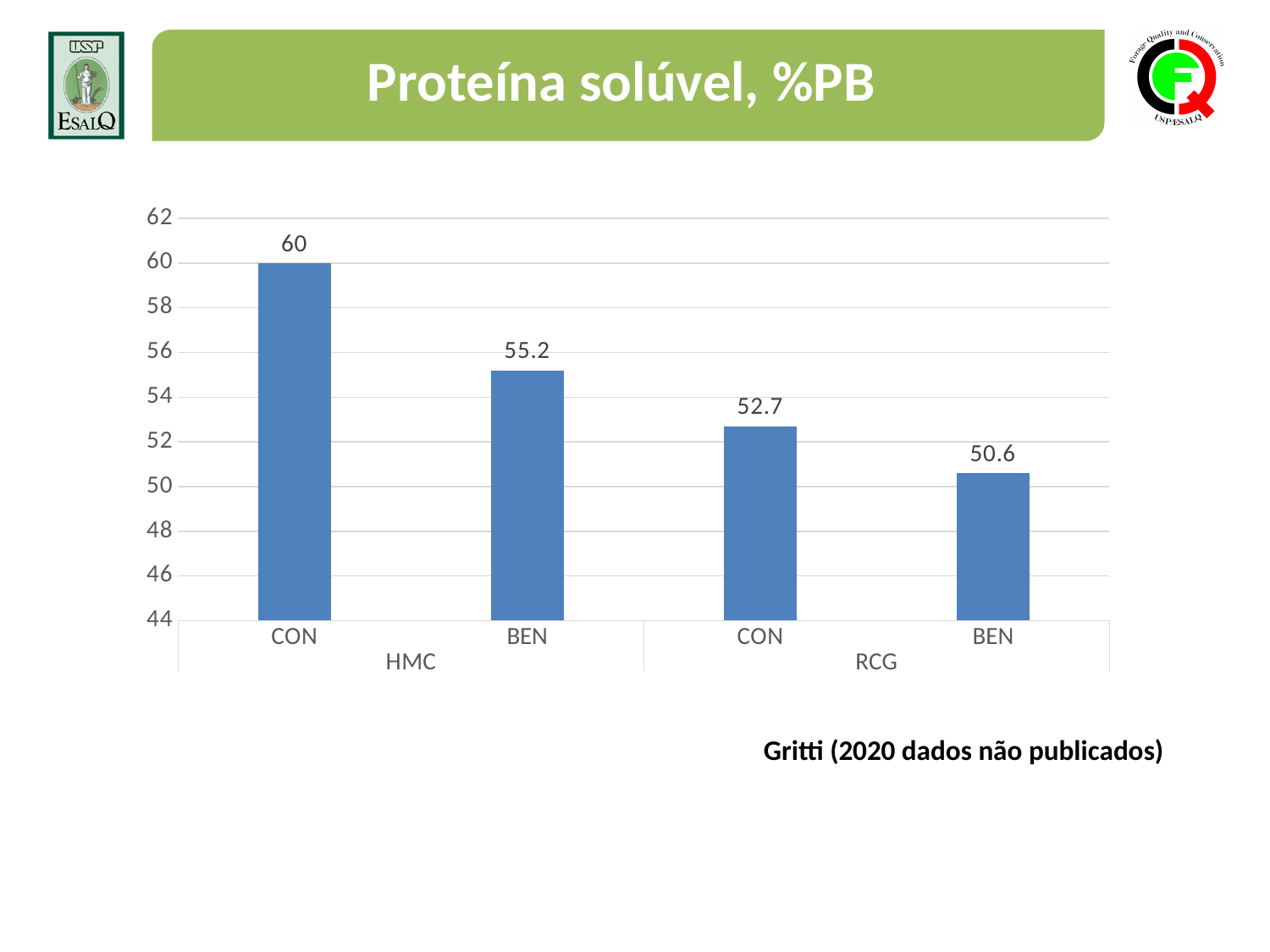
Which is larger, BEN under HMC or CON under RCG? BEN under HMC Which bar has the lowest value? BEN under RCG What is the title of the chart? Proteína solúvel, %PB How many bars are plotted in the chart? 4 What is the value for BEN under RCG? 50.6 What kind of chart is shown on the slide? bar chart Which bar has the highest value? CON under HMC Is the value for BEN under HMC greater or less than 54? greater What is the value for CON under HMC? 60 What is the value for CON under RCG? 52.7 What is the difference between CON and BEN under HMC? 4.8 What is the difference between CON under HMC and CON under RCG? 7.3